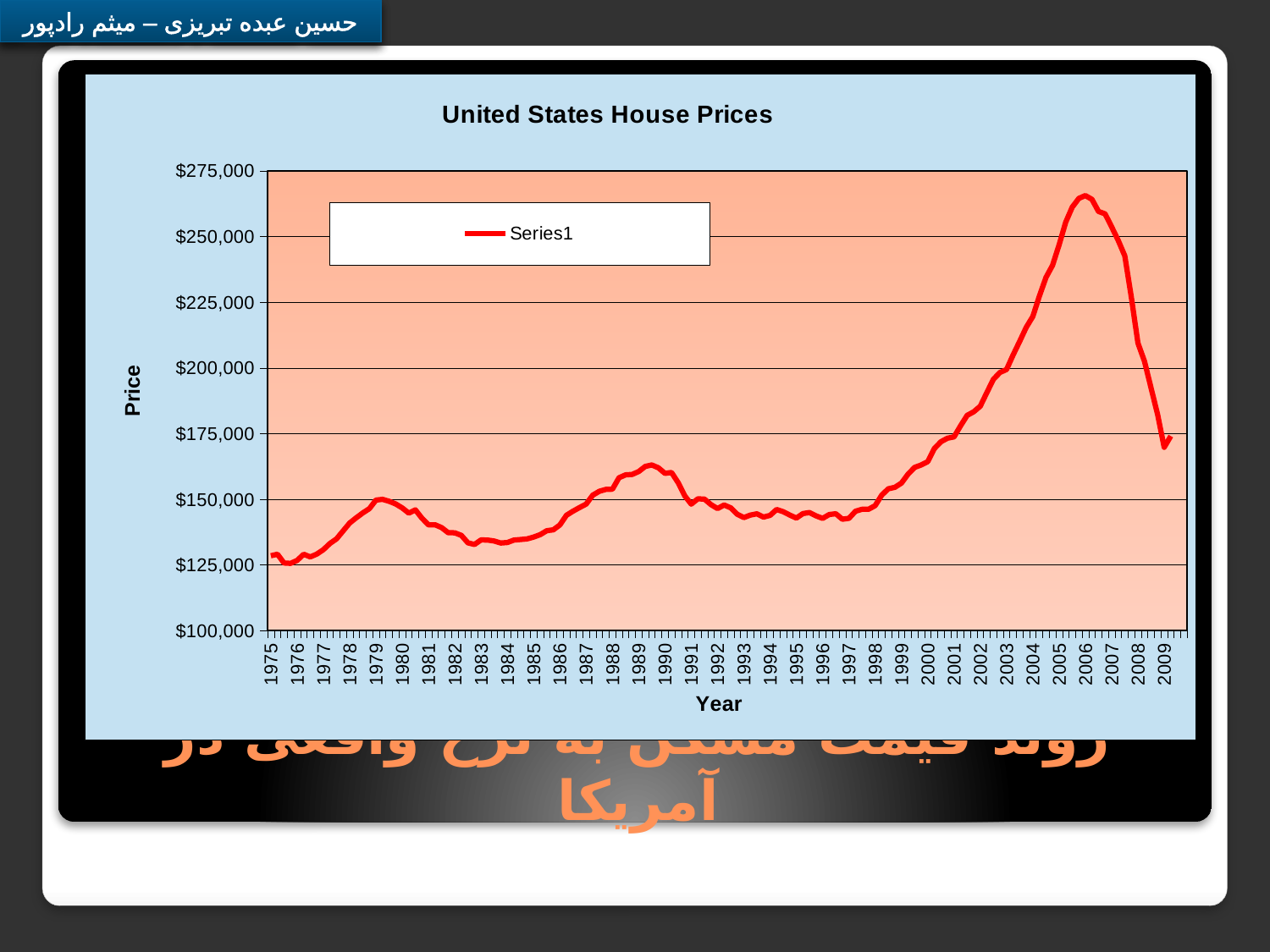
How many series does the legend list? 1 Is the value for 1989 greater or less than $150,000? greater What kind of chart is shown on the slide? line chart Is the value for 1975 greater or less than $150,000? less Is the value for 2006 greater or less than $250,000? greater What is the label of the vertical axis? Price Do house prices rise or fall between 2006 and 2009? fall How many year labels are shown along the x axis? 35 Do house prices rise or fall between 2000 and 2006? rise What is the title of the chart? United States House Prices In which year does the house price reach its highest point? 2006